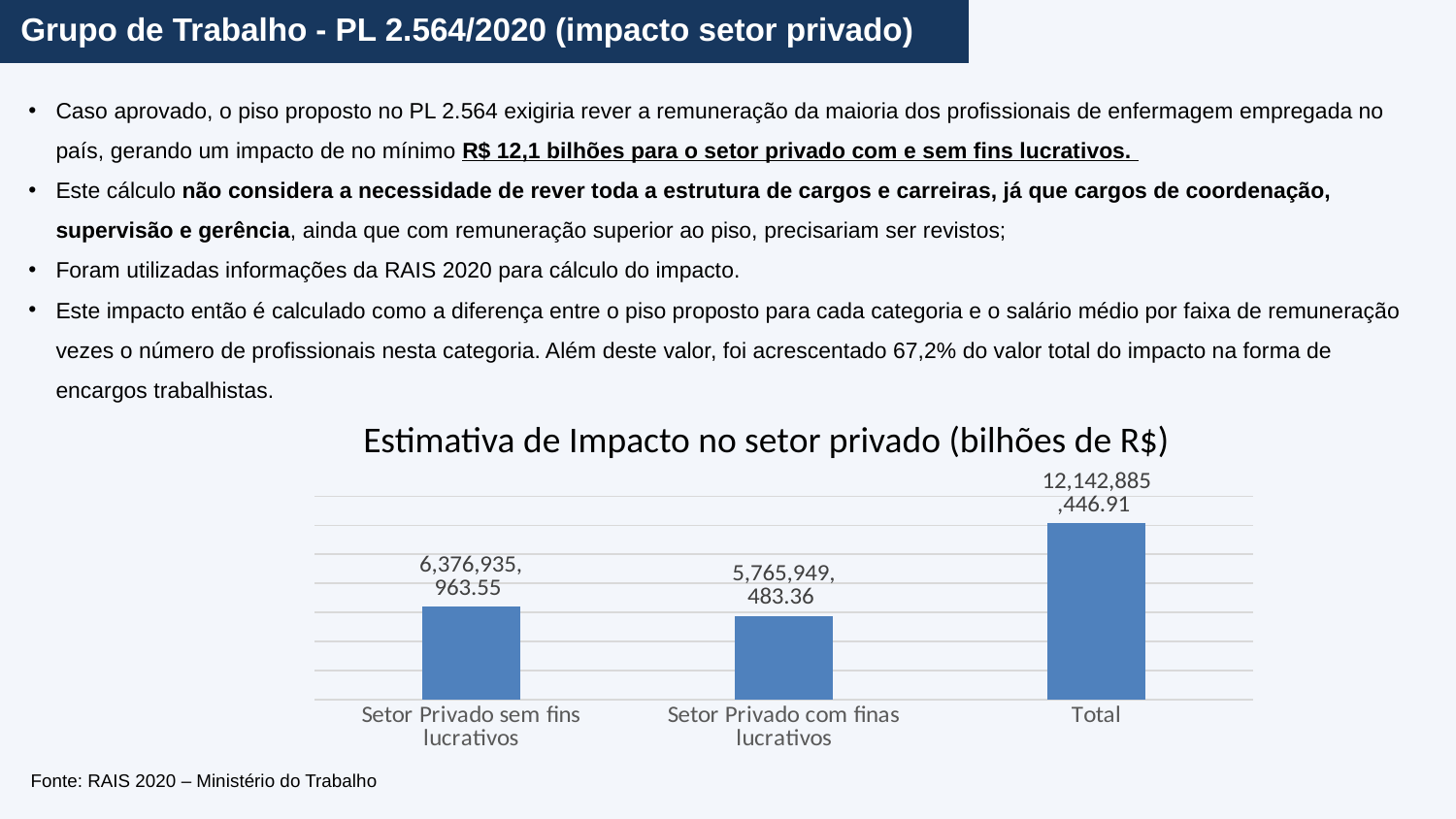
What is the title of the chart? Estimativa de Impacto no setor privado (bilhões de R$) What is the value for Setor Privado com finas lucrativos? 5,765,949,483.36 What is the value for Total? 12,142,885,446.91 Which is larger, the value for Setor Privado sem fins lucrativos or Setor Privado com finas lucrativos? Setor Privado sem fins lucrativos How many categories are shown in the chart? 3 What type of chart is shown on the slide? Bar chart What is the source cited below the chart? RAIS 2020 – Ministério do Trabalho Which category has the highest value? Total What is the value for Setor Privado sem fins lucrativos? 6,376,935,963.55 Which category has the lowest value? Setor Privado com finas lucrativos What is the difference between the values for Setor Privado sem fins lucrativos and Setor Privado com finas lucrativos? 610,986,480.19 What is the sum of the values for Setor Privado sem fins lucrativos and Setor Privado com finas lucrativos? 12,142,885,446.91